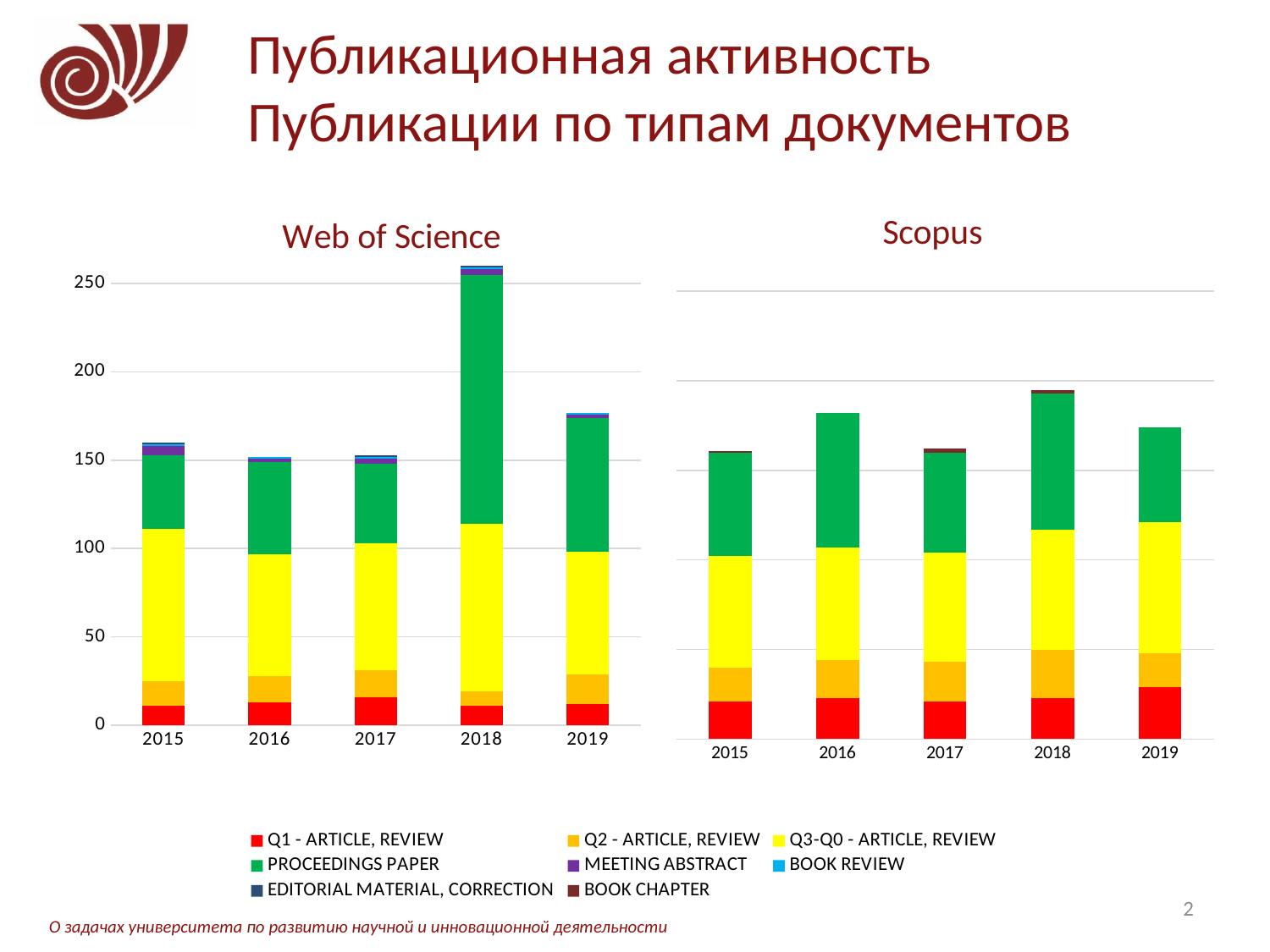
Which colour represents the Q1 - ARTICLE, REVIEW series in the legend? red In the Web of Science chart, is the total for 2018 greater or less than 250? greater In the Web of Science chart, is the total for 2015 greater or less than 150? greater In the Scopus chart, which year has the tallest bar? 2018 What kind of chart is the Web of Science chart? stacked bar chart In the Web of Science chart, is the Q1 - ARTICLE, REVIEW segment for 2015 greater or less than 50? less How many series does the legend list? 8 In the Web of Science chart, which year has the tallest bar? 2018 In the Web of Science chart, which bar is taller, 2018 or 2019? 2018 How many years are shown on the x axis of the Web of Science chart? 5 In the Scopus chart, which bar is taller, 2016 or 2019? 2016